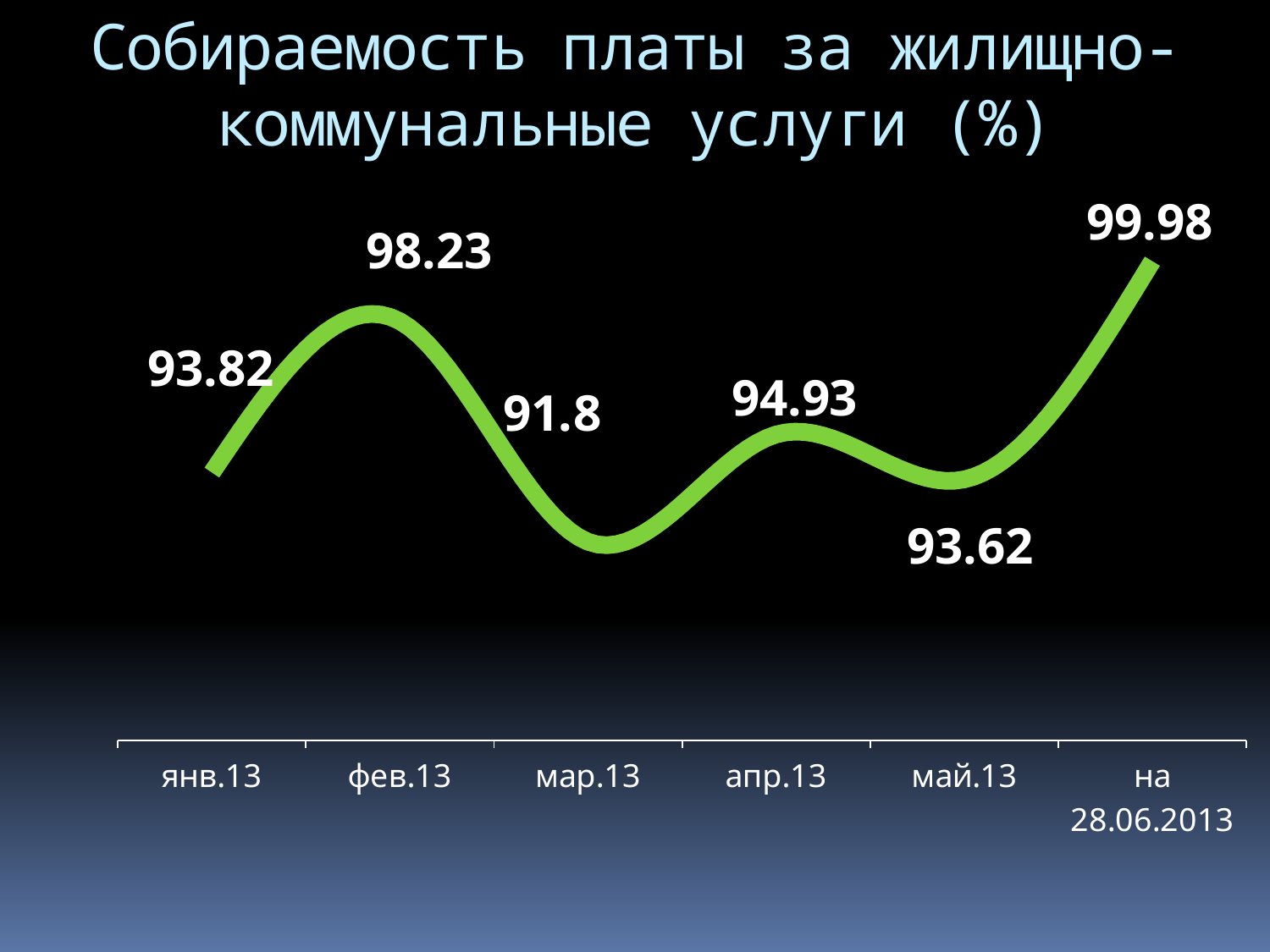
Which category has the highest value? на 28.06.2013 What is the value for на 28.06.2013? 99.98 Does the value rise or fall from май.13 to на 28.06.2013? rise How many data points are plotted on the chart? 6 Which is larger, the value for апр.13 or the value for май.13? апр.13 What kind of chart is shown on the slide? line chart What is the value for янв.13? 93.82 What is the difference between the values for фев.13 and мар.13? 6.43 What is the title of the chart? Собираемость платы за жилищно-коммунальные услуги (%) What is the value for май.13? 93.62 What is the value for мар.13? 91.8 Which category has the lowest value? мар.13